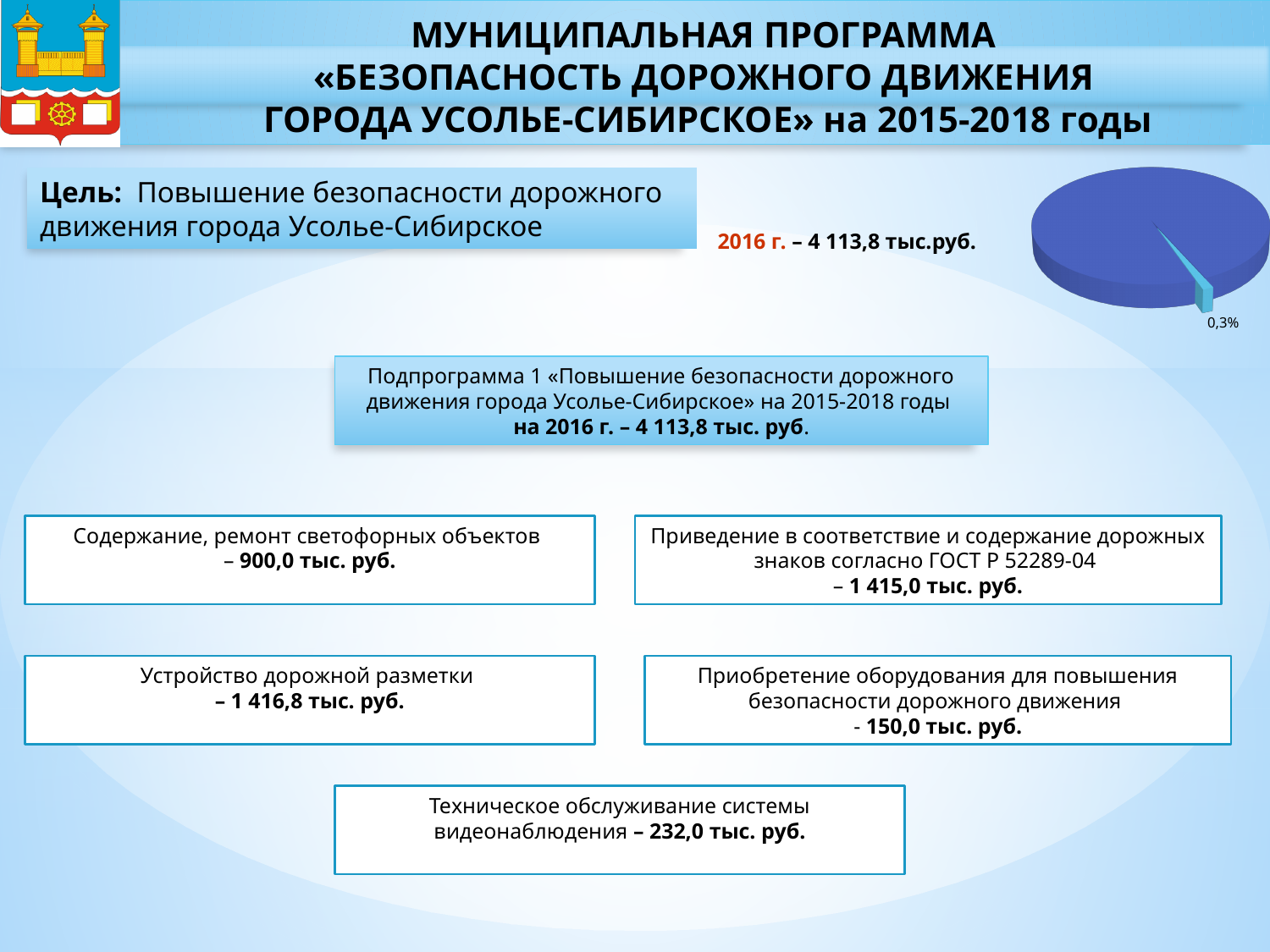
Which slice of the pie chart is larger, the dark blue one or the light blue one? the dark blue one What percentage is printed as the data label on the small slice of the pie chart? 0,3% How many slices does the pie chart have? 2 Does the pie chart have a legend? No What kind of chart is shown in the top-right corner of the slide? pie chart What colour is the large slice of the pie chart? dark blue